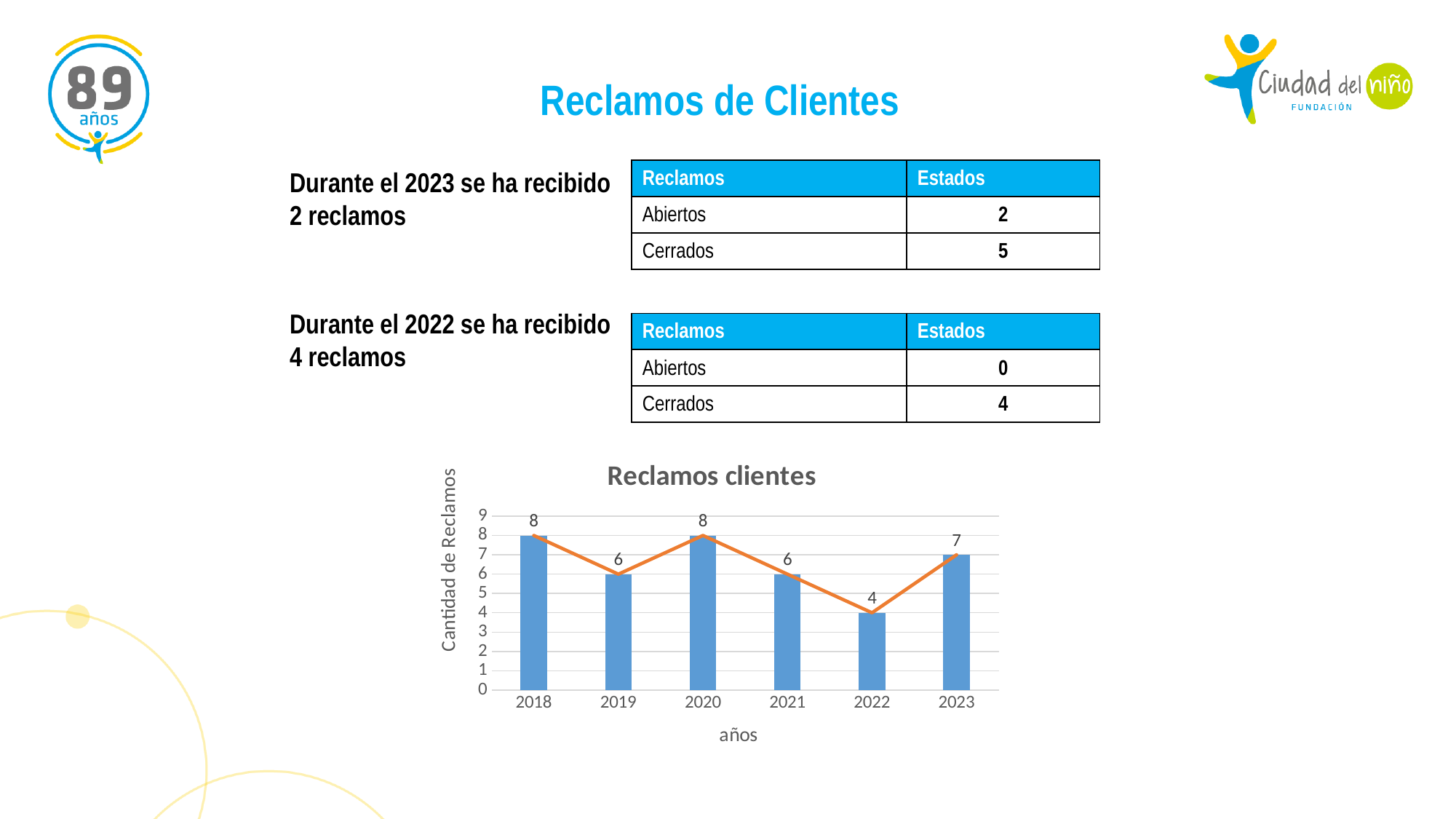
What is the value for 2023 in the chart? 7 Do the values rise or fall from 2022 to 2023? rise How many years are shown on the x axis of the chart? 6 What is the value for 2022 in the chart? 4 What is the difference between the values for 2023 and 2021? 1 Is the value for 2023 greater or less than 5? greater What is the title of the chart? Reclamos clientes Which year has the lowest value in the chart? 2022 What is the difference between the values for 2018 and 2022? 4 What kind of chart is shown on the slide? bar chart with a line overlay What is the value for 2019 in the chart? 6 Which is larger, the value for 2020 or the value for 2021? 2020